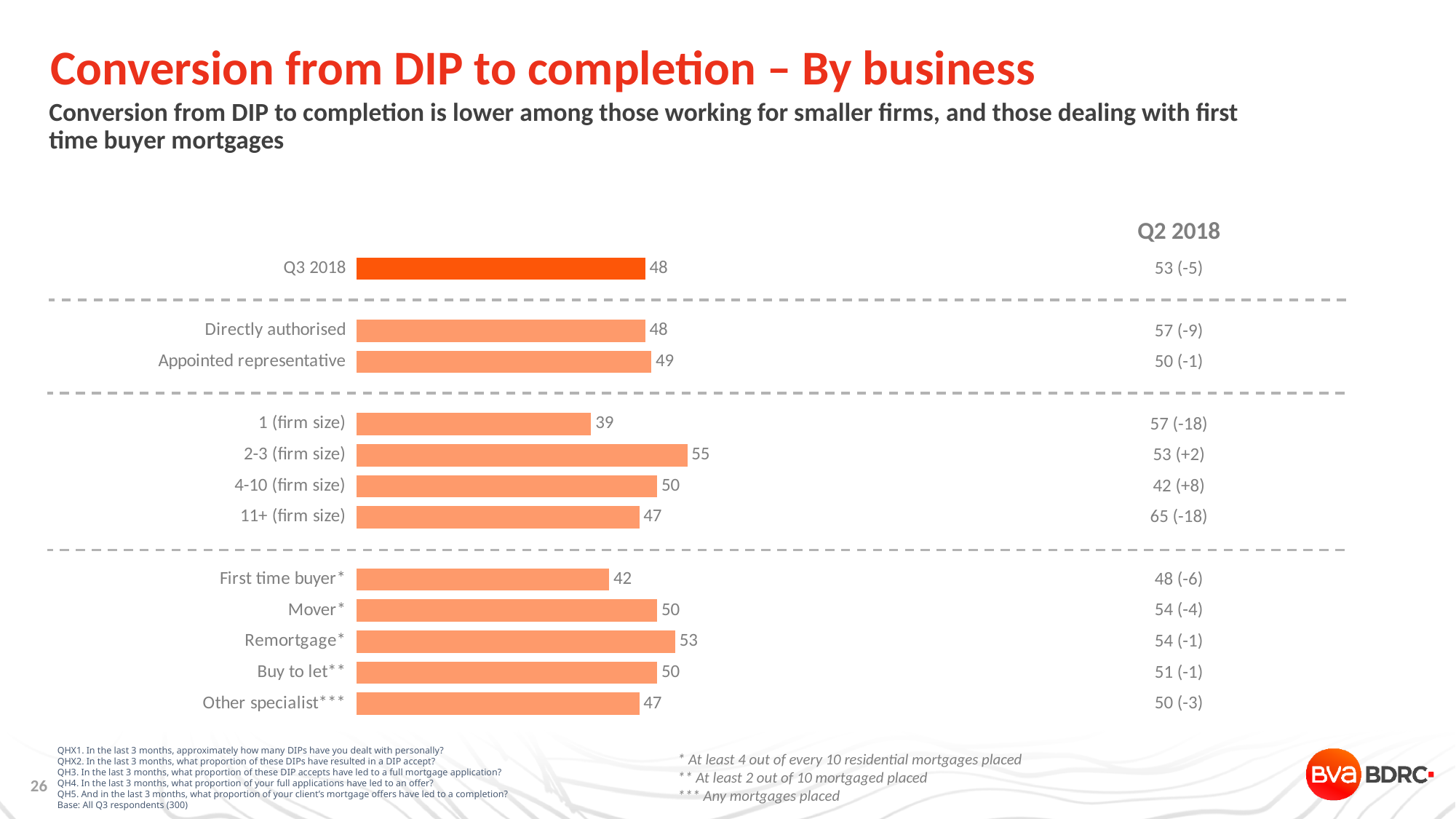
Which is larger, the value for Mover or the value for First time buyer? Mover What is the value for 1 (firm size)? 39 Which category has the highest value in the chart? 2-3 (firm size) What is the difference between the values for 2-3 (firm size) and 1 (firm size)? 16 What Q2 2018 value is shown for 11+ (firm size)? 65 (-18) How many bars are plotted in the chart? 12 What is the value for Appointed representative? 49 What is the value for Remortgage? 53 Which category has the lowest value in the chart? 1 (firm size) What kind of chart is shown on the slide? Bar chart What is the difference between the values for Remortgage and First time buyer? 11 What is the Q3 2018 overall value shown at the top of the chart? 48